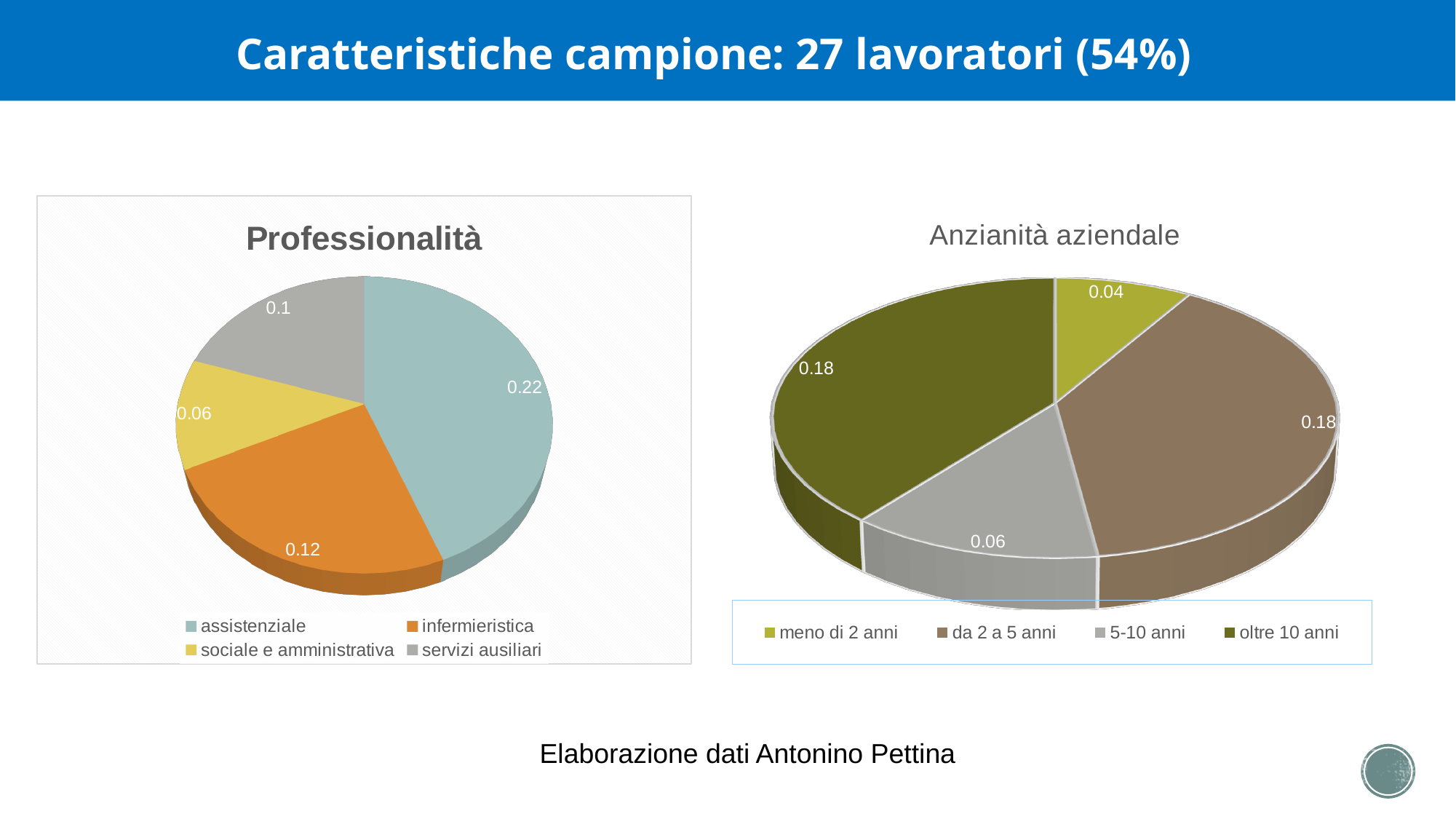
In the Anzianità aziendale chart, what is the value for meno di 2 anni? 0.04 In the Professionalità chart, what is the value for infermieristica? 0.12 In the Anzianità aziendale chart, which is larger: the value for da 2 a 5 anni or the value for 5-10 anni? da 2 a 5 anni In the Professionalità chart, what is the difference between the values for assistenziale and servizi ausiliari? 0.12 What kind of chart is the Anzianità aziendale chart? pie chart In the Professionalità chart, what is the value for assistenziale? 0.22 In the Anzianità aziendale chart, what is the value for 5-10 anni? 0.06 In the Professionalità chart, which category has the smallest slice? sociale e amministrativa In the Professionalità chart, how many categories does the legend list? 4 In the Professionalità chart, which category has the largest slice? assistenziale In the Anzianità aziendale chart, what is the difference between the values for oltre 10 anni and meno di 2 anni? 0.14 In the Anzianità aziendale chart, which category has the smallest slice? meno di 2 anni